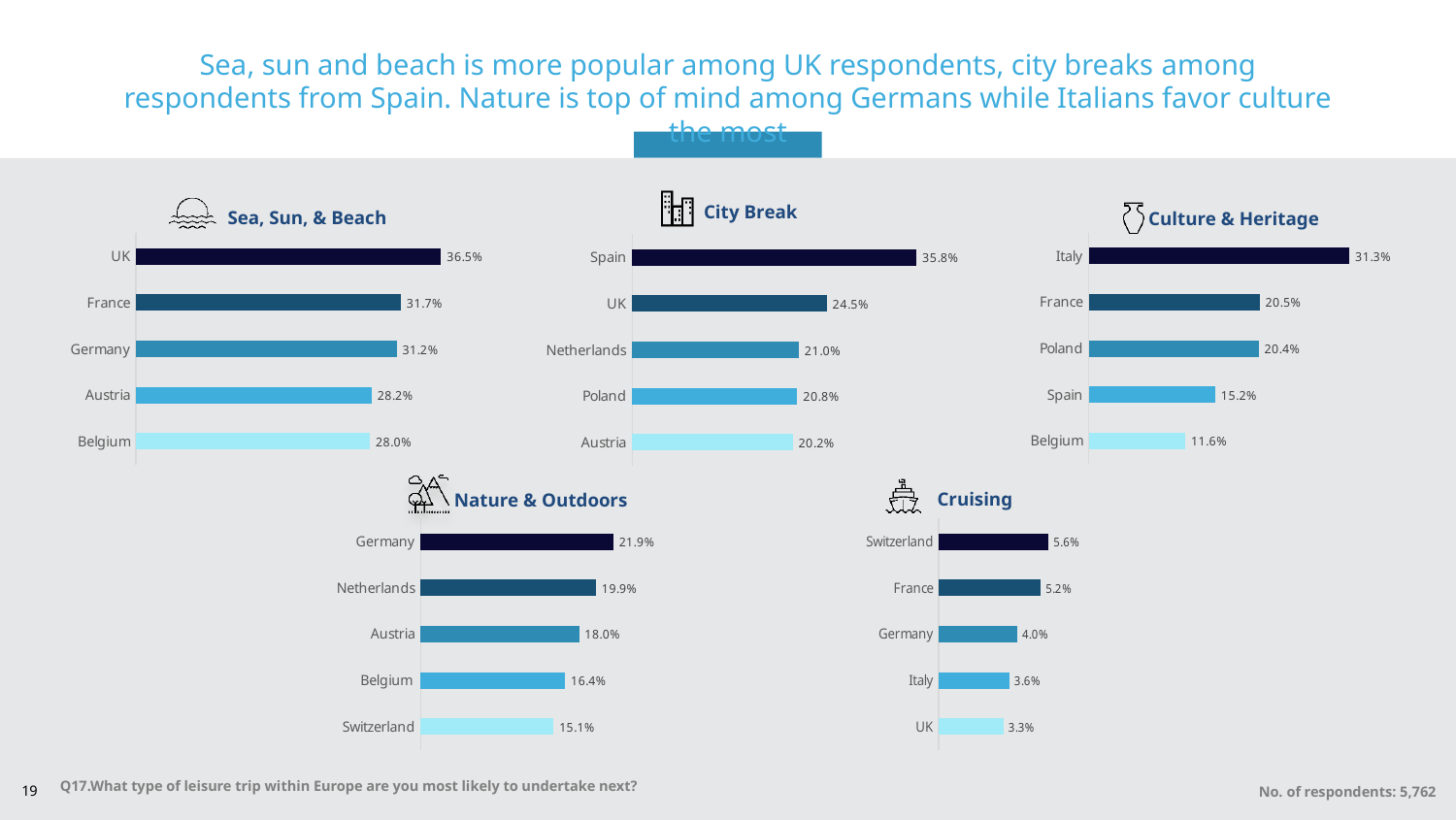
In the Culture & Heritage chart, what is the value for Belgium? 11.6% How many charts are shown on the slide? 5 In the City Break chart, what is the value for Poland? 20.8% What type of chart is the Culture & Heritage chart? Bar chart In the Nature & Outdoors chart, which country has the lowest value? Switzerland In the Nature & Outdoors chart, what is the value for Germany? 21.9% In the Cruising chart, what is the difference between Switzerland and the UK? 2.3% In the City Break chart, which country has the highest value? Spain In the Sea, Sun, & Beach chart, what is the value for the UK? 36.5% How many countries are shown in the City Break chart? 5 In the Sea, Sun, & Beach chart, which is larger, the value for France or the value for Austria? France In the Culture & Heritage chart, what is the difference between Italy and France? 10.8%